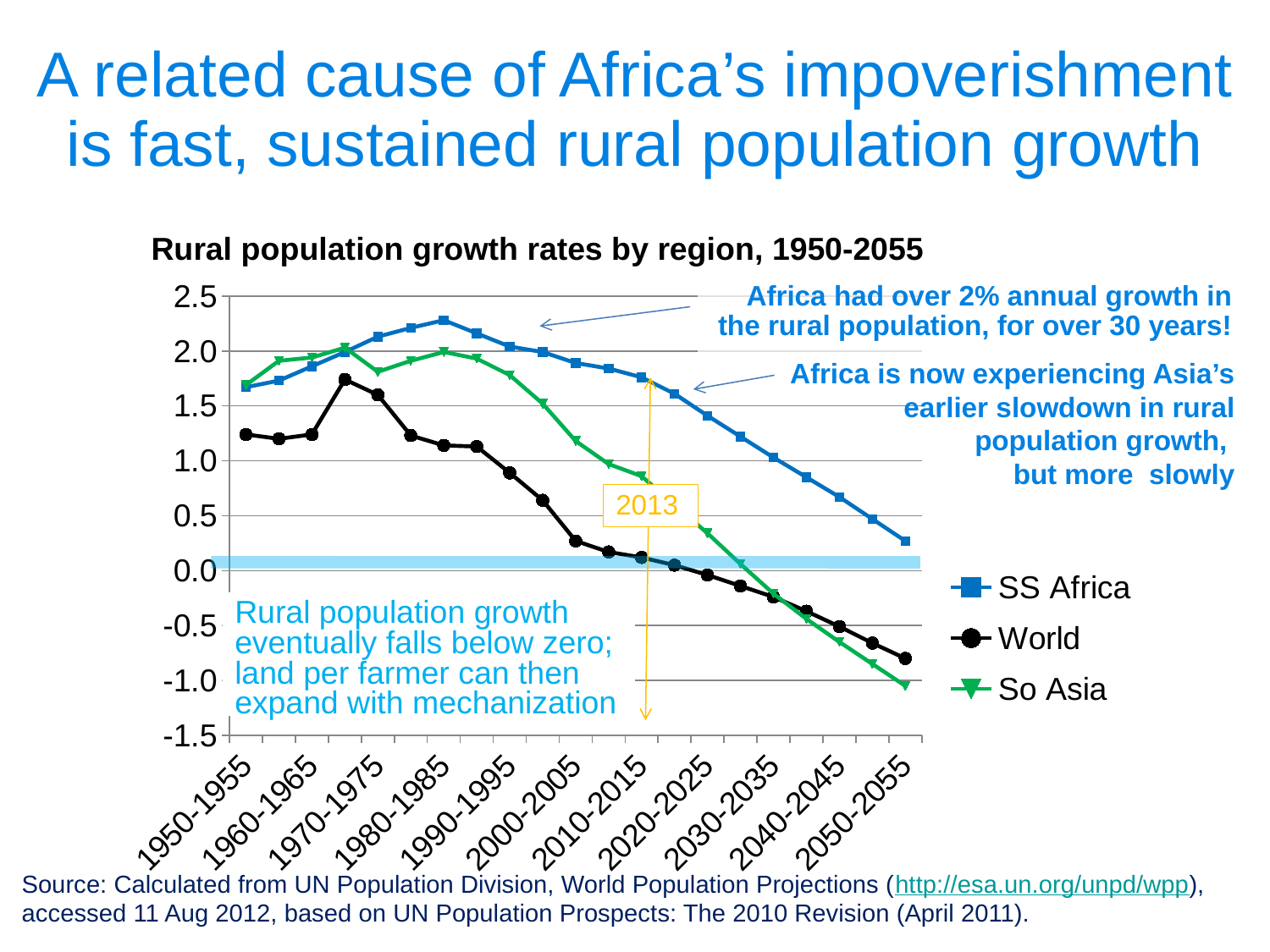
Is the value for World in 2050-2055 greater or less than -0.5? less What are the three series named in the legend? SS Africa, World, So Asia In 1990-1995, which is larger, the value for So Asia or the value for World? So Asia Is the value for World in 1950-1955 greater or less than 1.0? greater Does the World series generally rise or fall from 1970-1975 to 2050-2055? fall What kind of chart is shown on the slide? line chart Is the value for SS Africa in 2050-2055 greater or less than 0.0? greater Which series has the highest value in 2050-2055? SS Africa What is the title of the chart? Rural population growth rates by region, 1950-2055 How many series does the legend list? 3